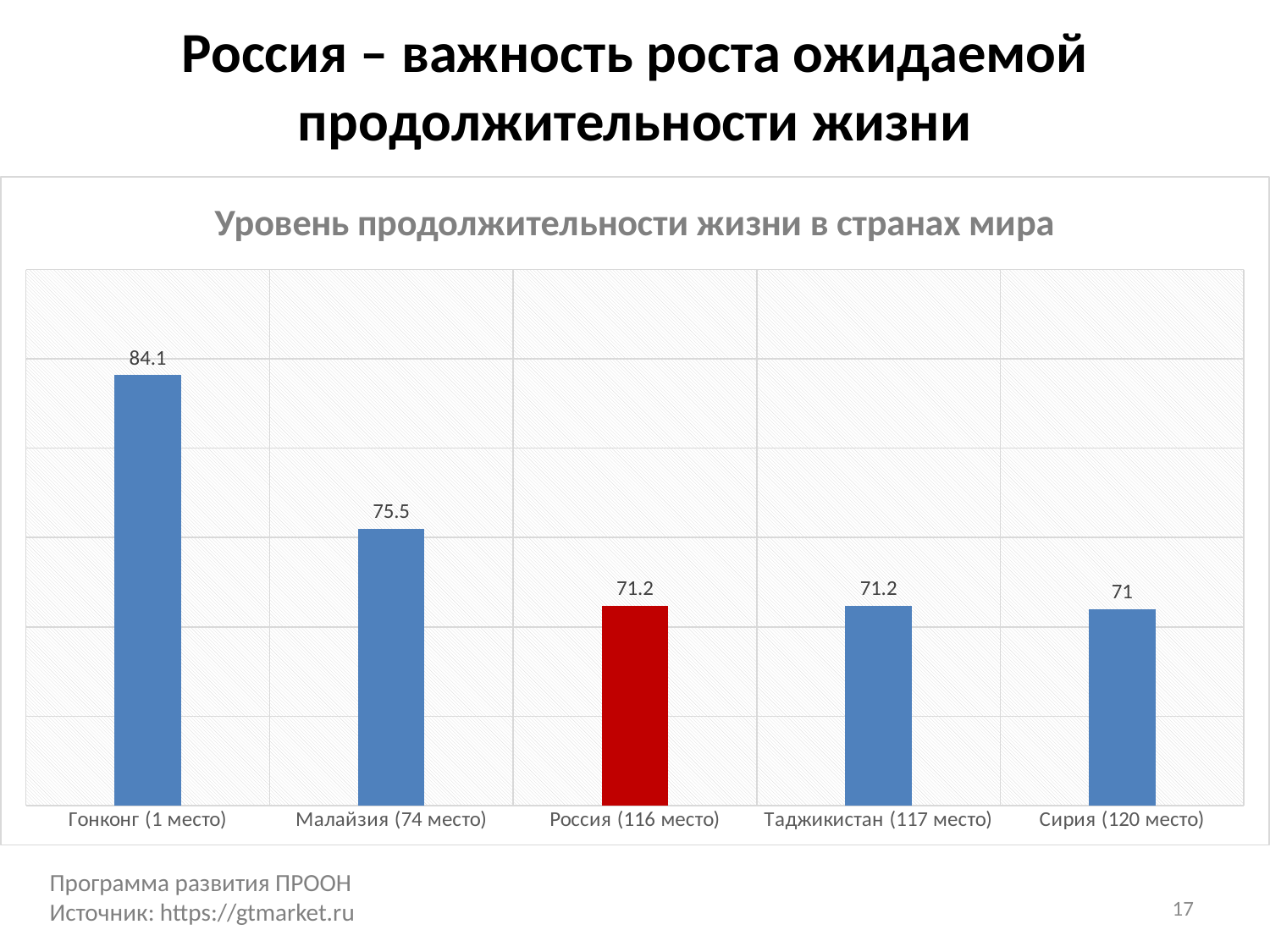
How many categories are shown in the chart? 5 Which category has the highest value? Гонконг (1 место) Which is larger, the value for Малайзия (74 место) or the value for Россия (116 место)? Малайзия (74 место) What is the value for Гонконг (1 место)? 84.1 What is the value for Сирия (120 место)? 71 What is the value for Россия (116 место)? 71.2 What is the difference between the values for Гонконг (1 место) and Россия (116 место)? 12.9 What is the difference between the values for Малайзия (74 место) and Таджикистан (117 место)? 4.3 What is the value for Малайзия (74 место)? 75.5 What kind of chart is shown on the slide? bar chart Which category has the lowest value? Сирия (120 место) What is the title of the chart? Уровень продолжительности жизни в странах мира